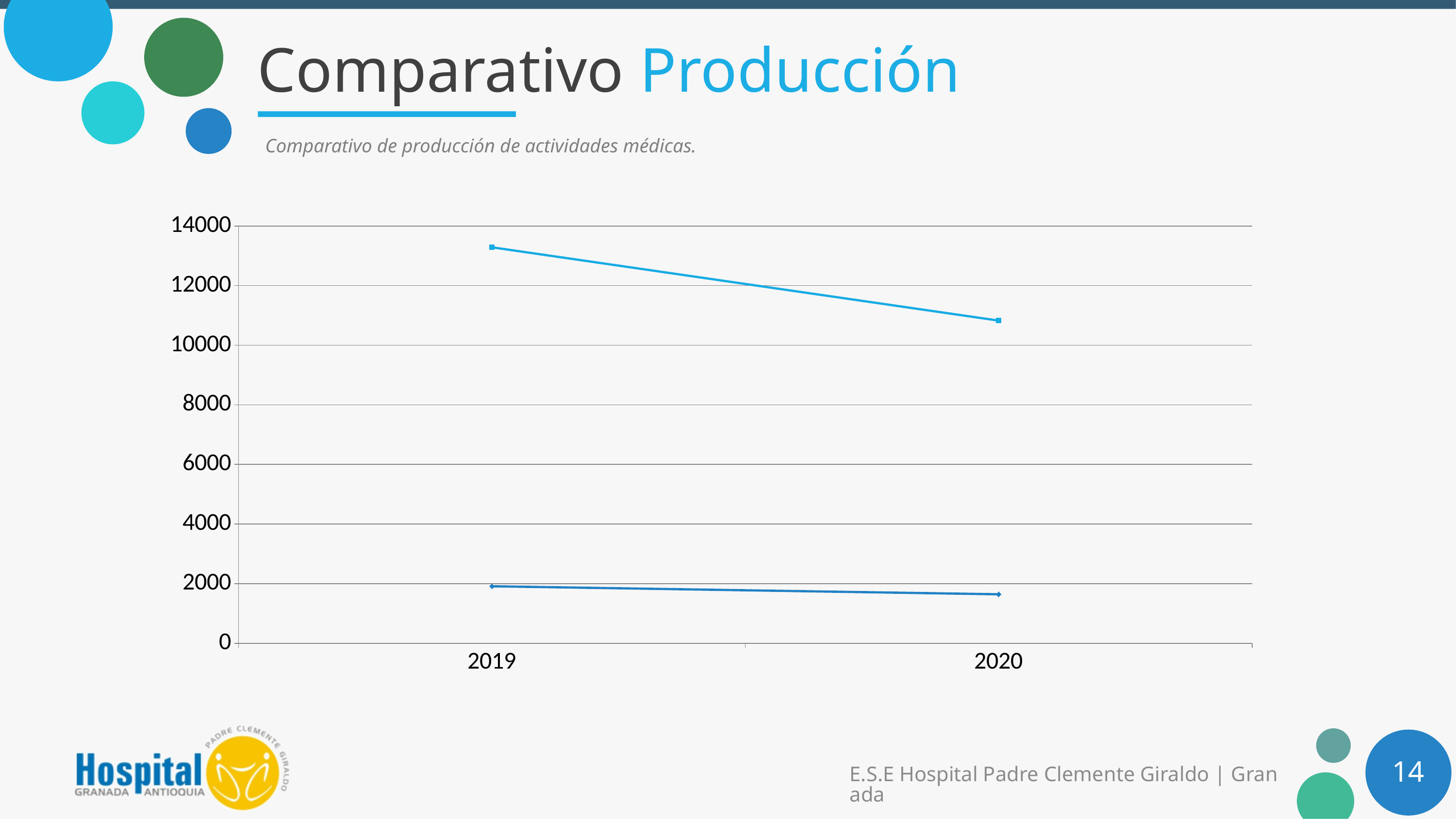
Is the value of the upper line in 2019 greater or less than 12000? greater For the upper line, which year has the larger value, 2019 or 2020? 2019 Is the value of the lower line in 2019 greater or less than 4000? less Does the lower line rise or fall from 2019 to 2020? fall Is the value of the upper line in 2020 greater or less than 12000? less How many years are shown on the x axis of the chart? 2 How many lines are plotted on the chart? 2 What kind of chart is shown on the slide? line chart Does the upper line rise or fall from 2019 to 2020? fall What is the highest value shown on the y axis of the chart? 14000